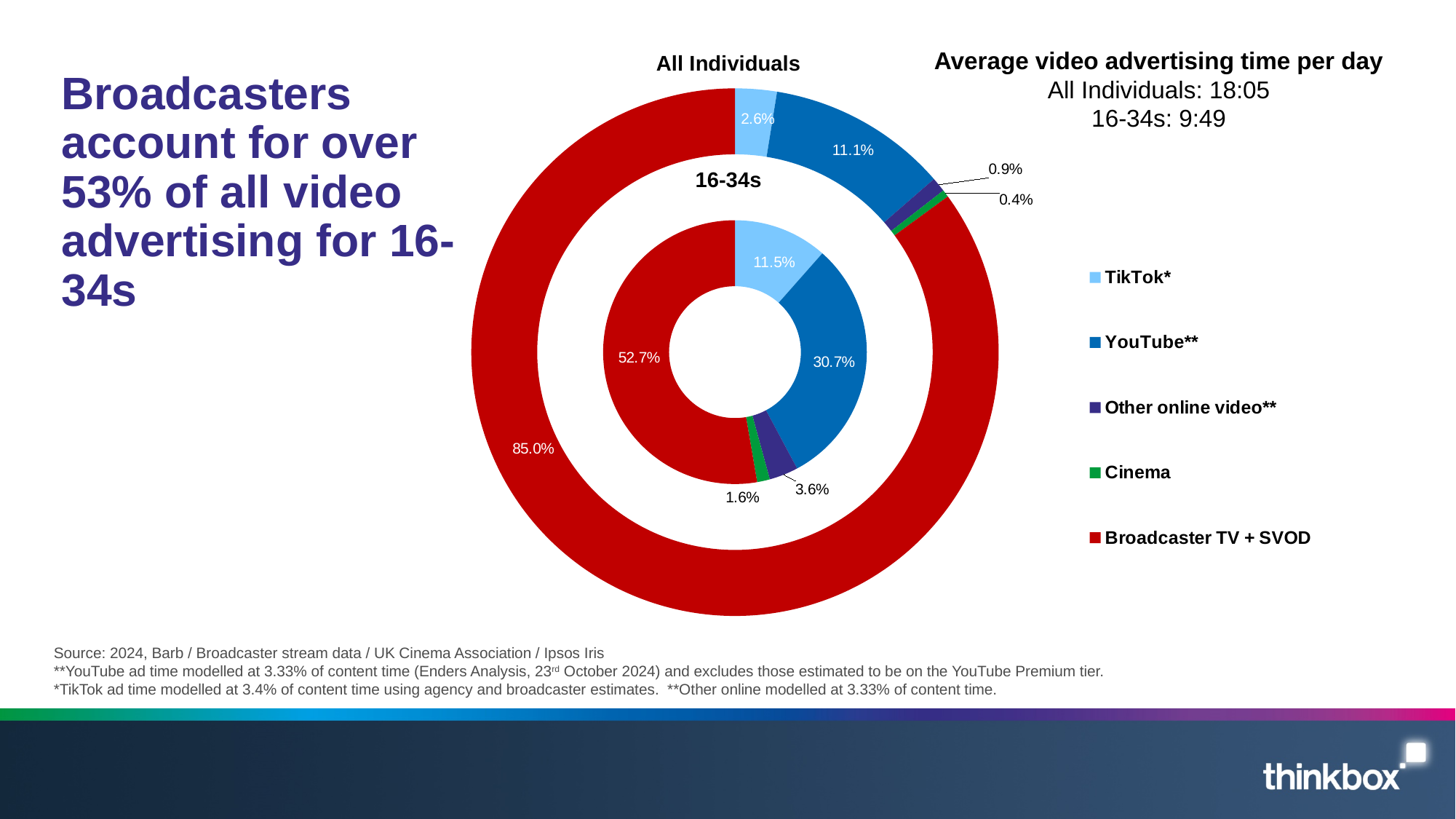
What kind of chart is shown on the slide? Doughnut chart Which category has the largest share in the 16-34s ring? Broadcaster TV + SVOD In the All Individuals ring, what share does Broadcaster TV + SVOD account for? 85.0% Which category has the smallest share in the All Individuals ring? Cinema How many categories does the legend list? 5 In the 16-34s ring, what share does TikTok* account for? 11.5% In the 16-34s ring, what share does YouTube** account for? 30.7% Which is larger: the YouTube** share for 16-34s or the YouTube** share for All Individuals? 16-34s What is the difference between the Broadcaster TV + SVOD share for All Individuals and for 16-34s? 32.3 percentage points In the 16-34s ring, what share does Other online video** account for? 3.6% According to the text on the slide, what is the average video advertising time per day for 16-34s? 9:49 In the All Individuals ring, what share does Cinema account for? 0.4%